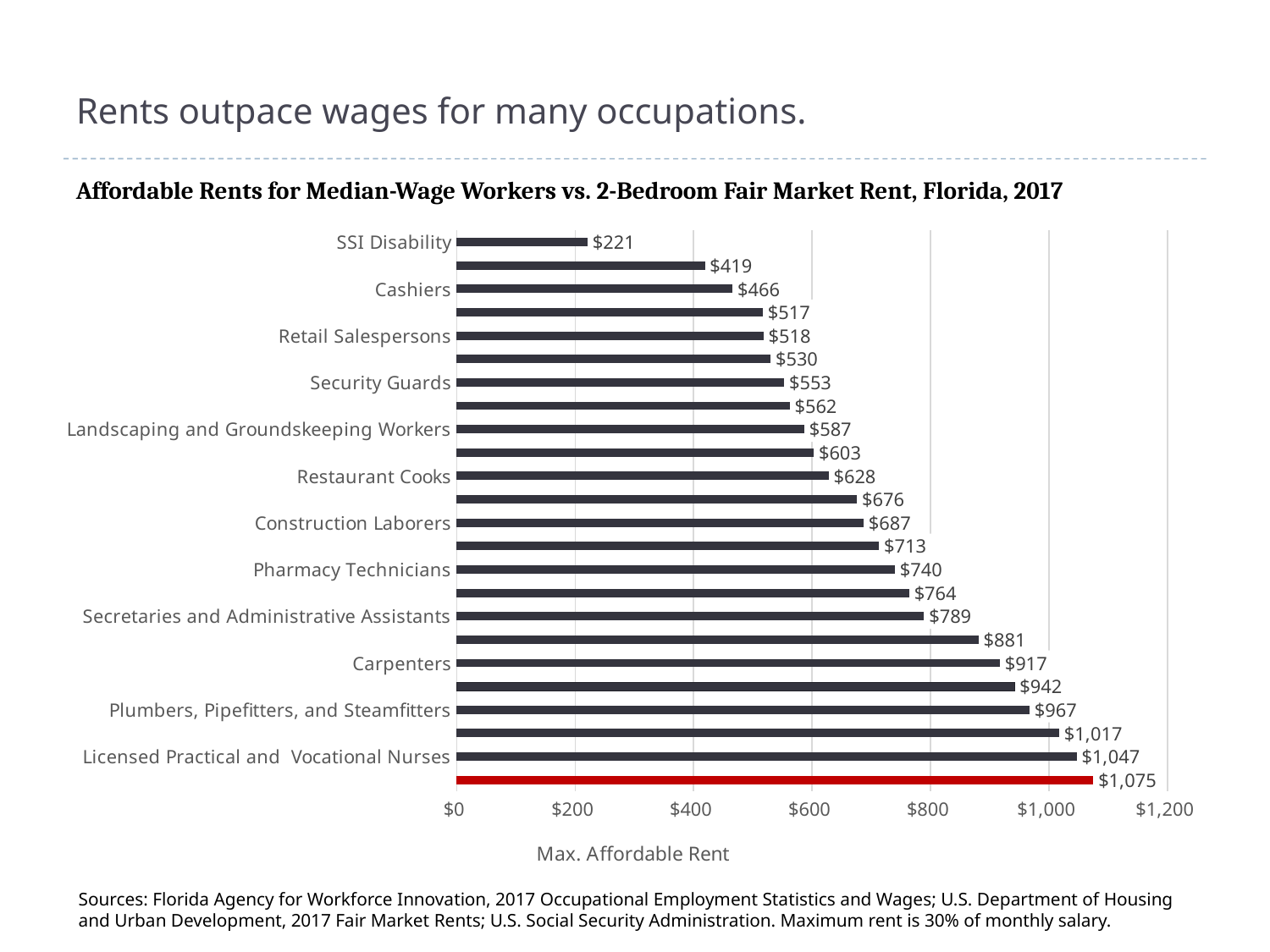
What is the difference between the max. affordable rent for Carpenters and for Cashiers? $451 What is the max. affordable rent for Licensed Practical and Vocational Nurses? $1,047 What is the max. affordable rent for Pharmacy Technicians? $740 Which labeled occupation has the lowest max. affordable rent? SSI Disability What is the value of the red bar at the bottom of the chart? $1,075 What kind of chart is shown on the slide? bar chart What is the max. affordable rent for Cashiers? $466 Which has a higher max. affordable rent, Security Guards or Restaurant Cooks? Restaurant Cooks How many bars are plotted on the chart? 24 Is the value for Construction Laborers greater or less than $600? greater What is the highest value shown on the chart? $1,075 What is the title of the horizontal axis? Max. Affordable Rent